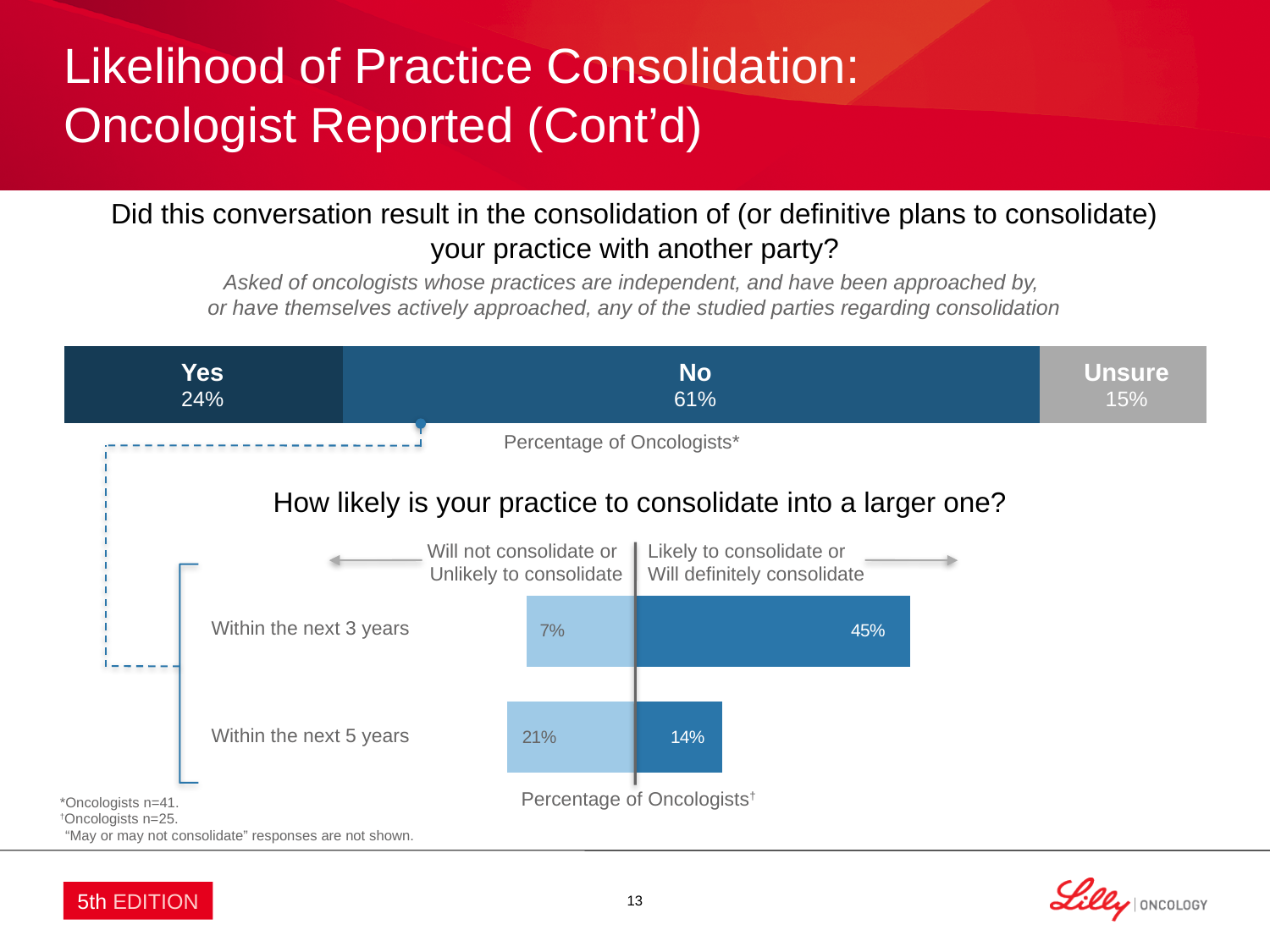
In the top bar chart, how many response categories are shown? 3 In the top bar chart, which response has the lowest percentage? Unsure In the bottom chart, how many time-frame categories are shown? 2 In the bottom chart, what percentage of oncologists are likely to consolidate or will definitely consolidate within the next 3 years? 45% In the bottom chart, what percentage of oncologists will not consolidate or are unlikely to consolidate within the next 5 years? 21% In the top bar chart, what is the difference between the "No" and "Yes" percentages? 37 percentage points In the bottom chart, which is larger for "Within the next 5 years": the will not/unlikely to consolidate value or the likely/will definitely consolidate value? Will not consolidate or Unlikely to consolidate In the top bar chart, which response has the highest percentage? No In the bottom chart, what is the difference between the likely/will definitely consolidate values for the next 3 years and the next 5 years? 31 percentage points In the top bar chart, what percentage of oncologists answered "No"? 61% What type of chart is the bottom chart? Bar chart In the top bar chart, what percentage of oncologists answered "Unsure"? 15%